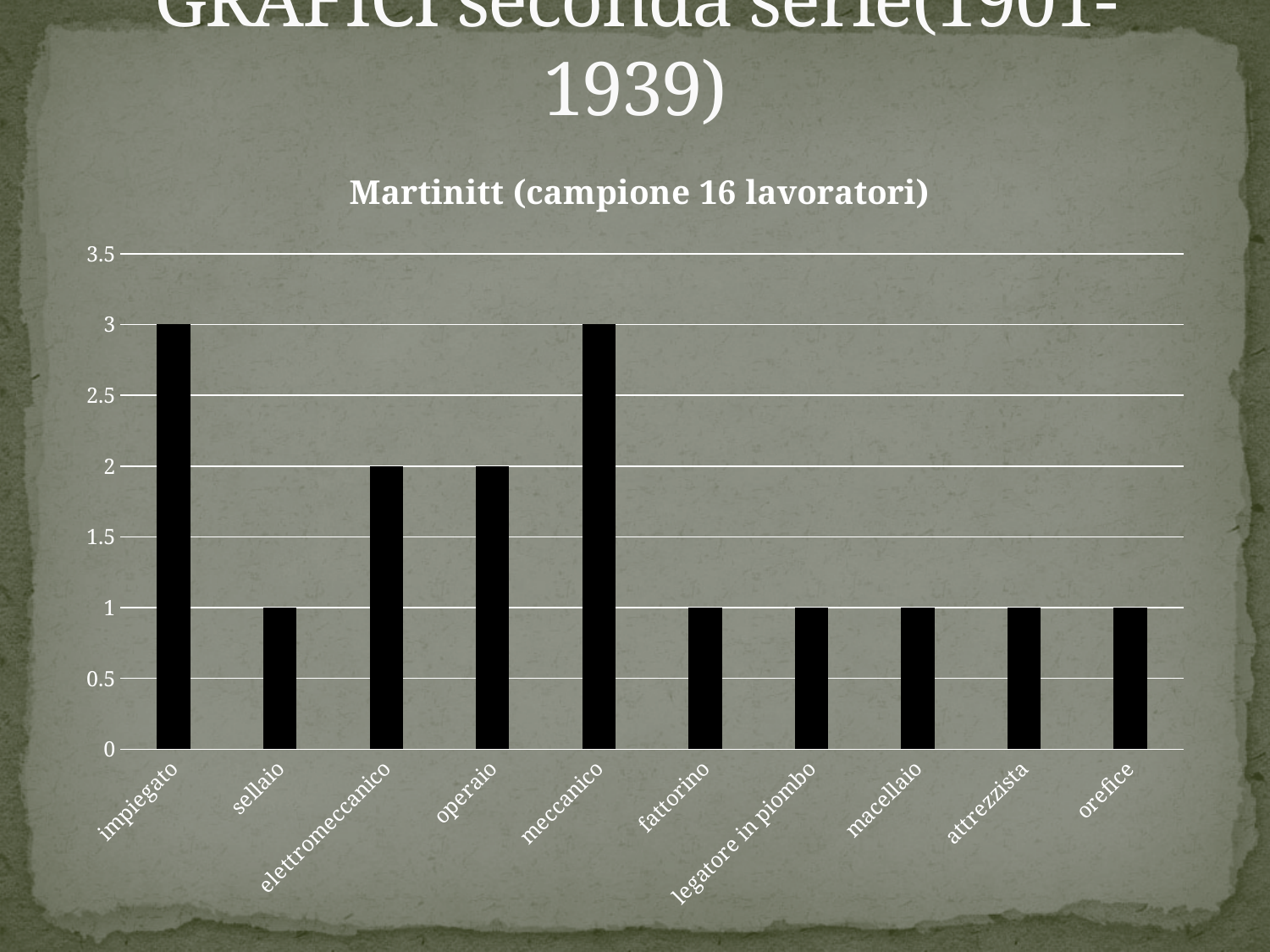
What is the difference between the values for meccanico and operaio? 1 What is the value for sellaio? 1 What is the value for meccanico? 3 Which has a larger value, macellaio or meccanico? meccanico How many categories are shown on the x axis? 10 What kind of chart is this? bar chart What is the title of the chart? Martinitt (campione 16 lavoratori) What is the value for operaio? 2 Which has a larger value, elettromeccanico or fattorino? elettromeccanico What is the difference between the values for impiegato and sellaio? 2 What is the value for impiegato? 3 What is the value for elettromeccanico? 2